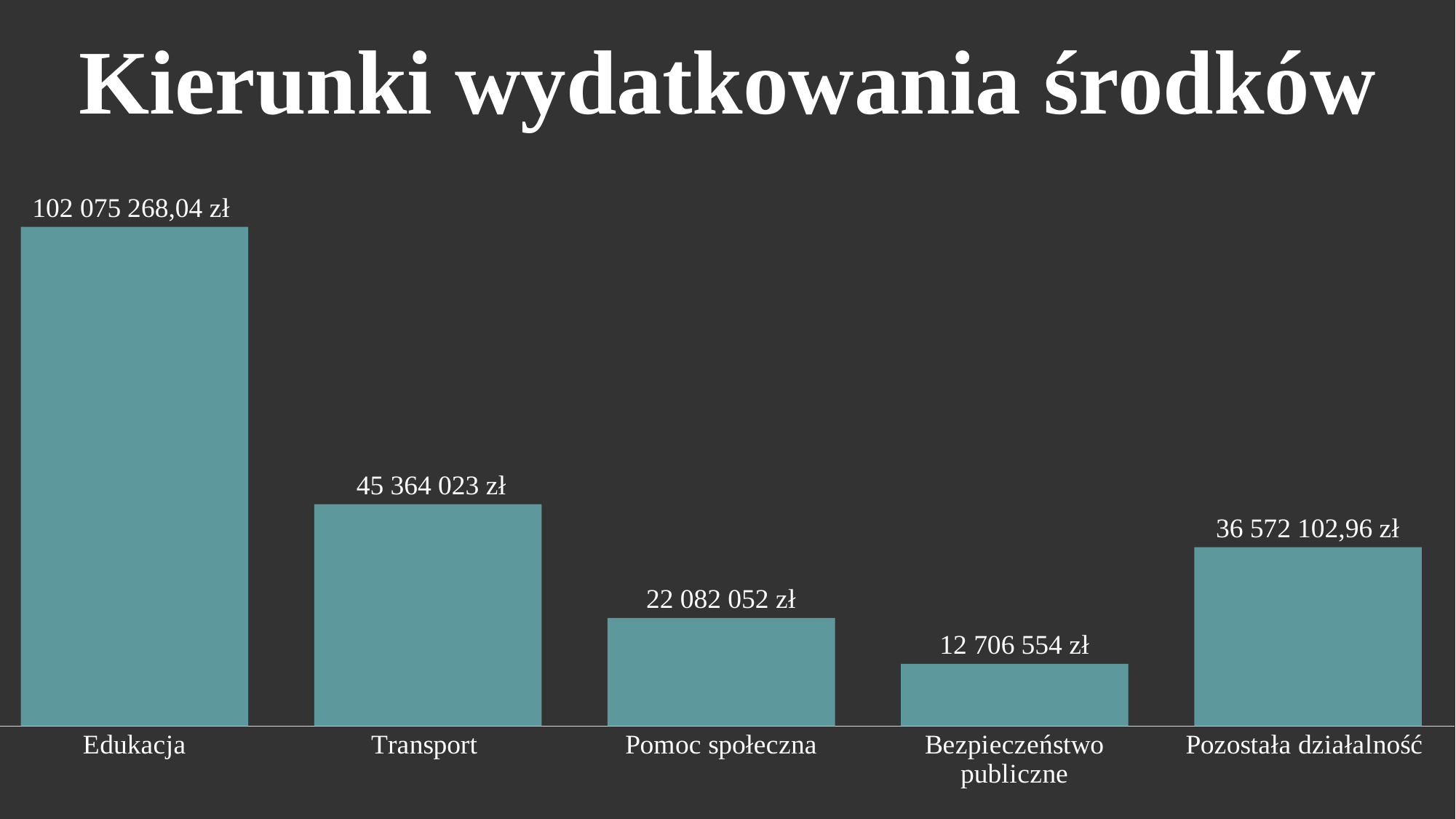
What is the value for Bezpieczeństwo publiczne? 12 706 554 zł What is the value for Pomoc społeczna? 22 082 052 zł What is the difference between the values for Transport and Pomoc społeczna? 23 281 971 zł Which category has the lowest value? Bezpieczeństwo publiczne Which category has the highest value? Edukacja What is the difference between the values for Pomoc społeczna and Bezpieczeństwo publiczne? 9 375 498 zł What is the value for Transport? 45 364 023 zł What kind of chart is shown on the slide? Bar chart What is the value for Edukacja? 102 075 268,04 zł What is the value for Pozostała działalność? 36 572 102,96 zł How many categories are shown in the chart? 5 Which is larger, the value for Pozostała działalność or the value for Pomoc społeczna? Pozostała działalność